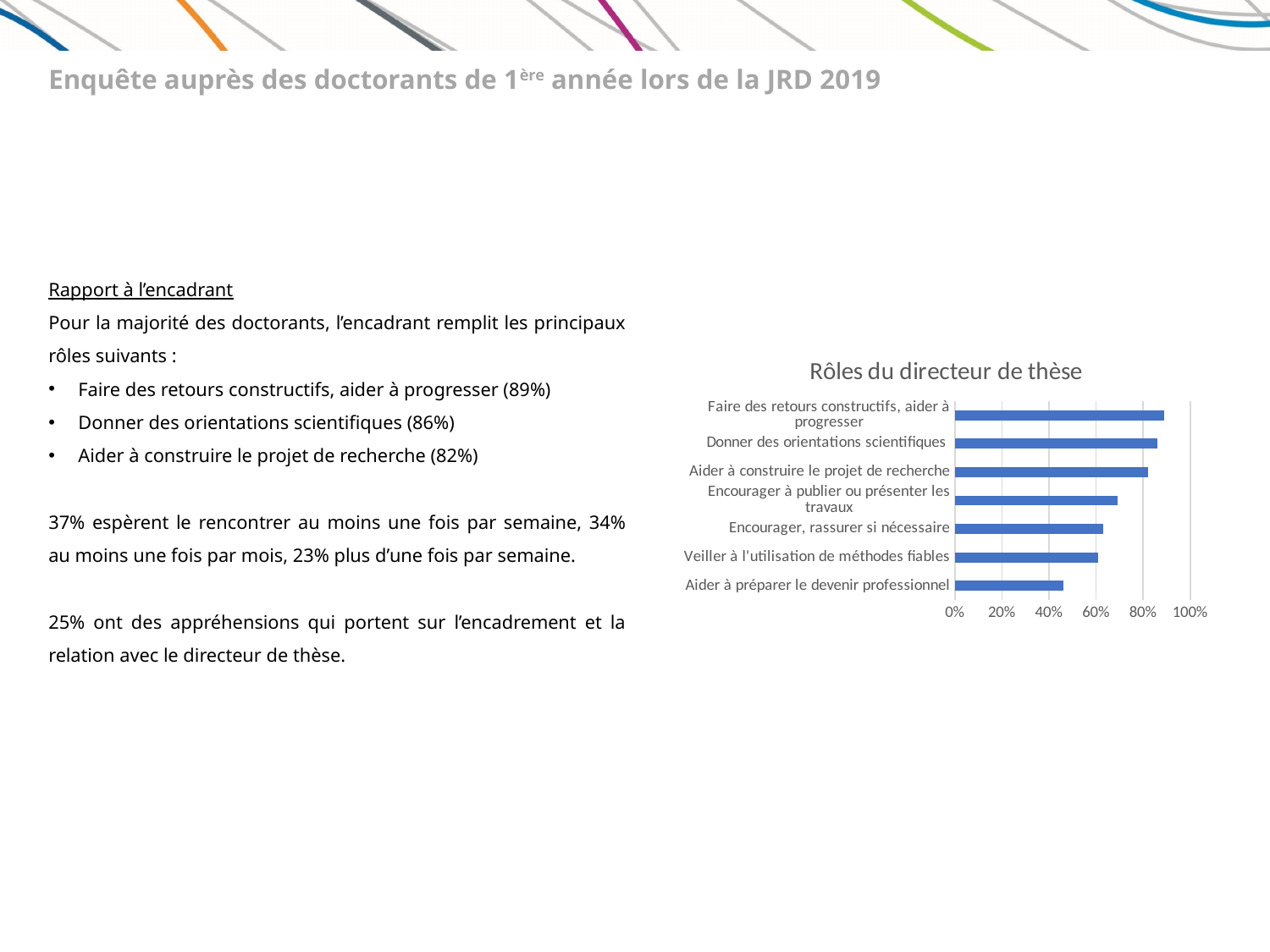
Is the value for 'Donner des orientations scientifiques' greater or less than 80%? greater What is the title of the chart? Rôles du directeur de thèse What is the highest value shown on the horizontal axis of the chart? 100% Which category has the lowest value in the chart? Aider à préparer le devenir professionnel What kind of chart is shown on the slide? bar chart Is the value for 'Aider à préparer le devenir professionnel' greater or less than 40%? greater Which is larger: the value for 'Donner des orientations scientifiques' or the value for 'Veiller à l'utilisation de méthodes fiables'? Donner des orientations scientifiques Is the value for 'Aider à préparer le devenir professionnel' greater or less than 60%? less How many categories are plotted in the chart? 7 Which category has the highest value in the chart? Faire des retours constructifs, aider à progresser